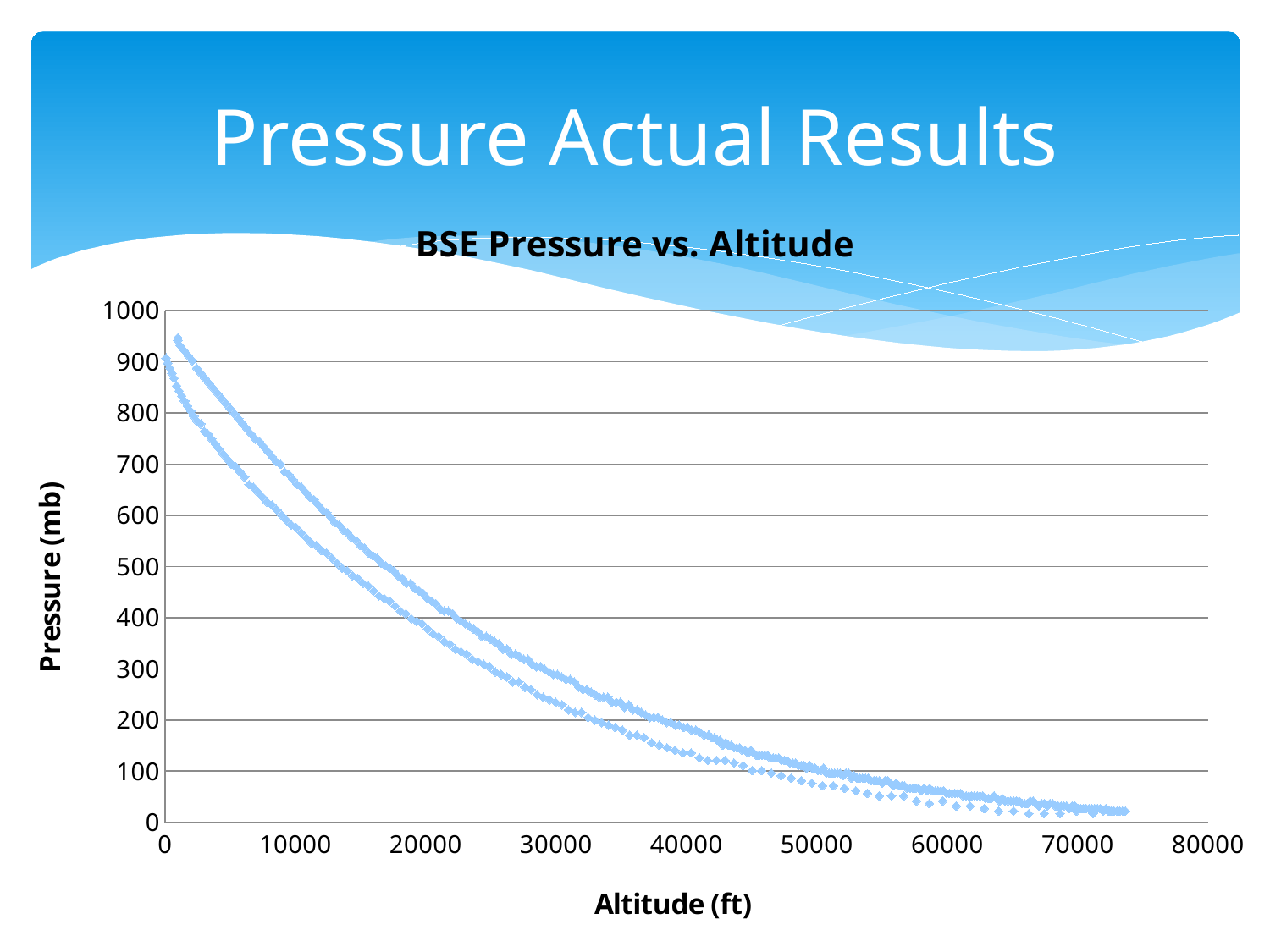
Is the pressure at an altitude of 30000 ft greater or less than 500? less Is the pressure at an altitude of 10000 ft greater or less than 500? greater Is the pressure at an altitude of 20000 ft greater or less than 300? greater As altitude increases along the x axis, does the pressure rise or fall? fall What is the title of the chart? BSE Pressure vs. Altitude What kind of chart is shown on the slide? scatter chart What is the label of the vertical axis of the chart? Pressure (mb)